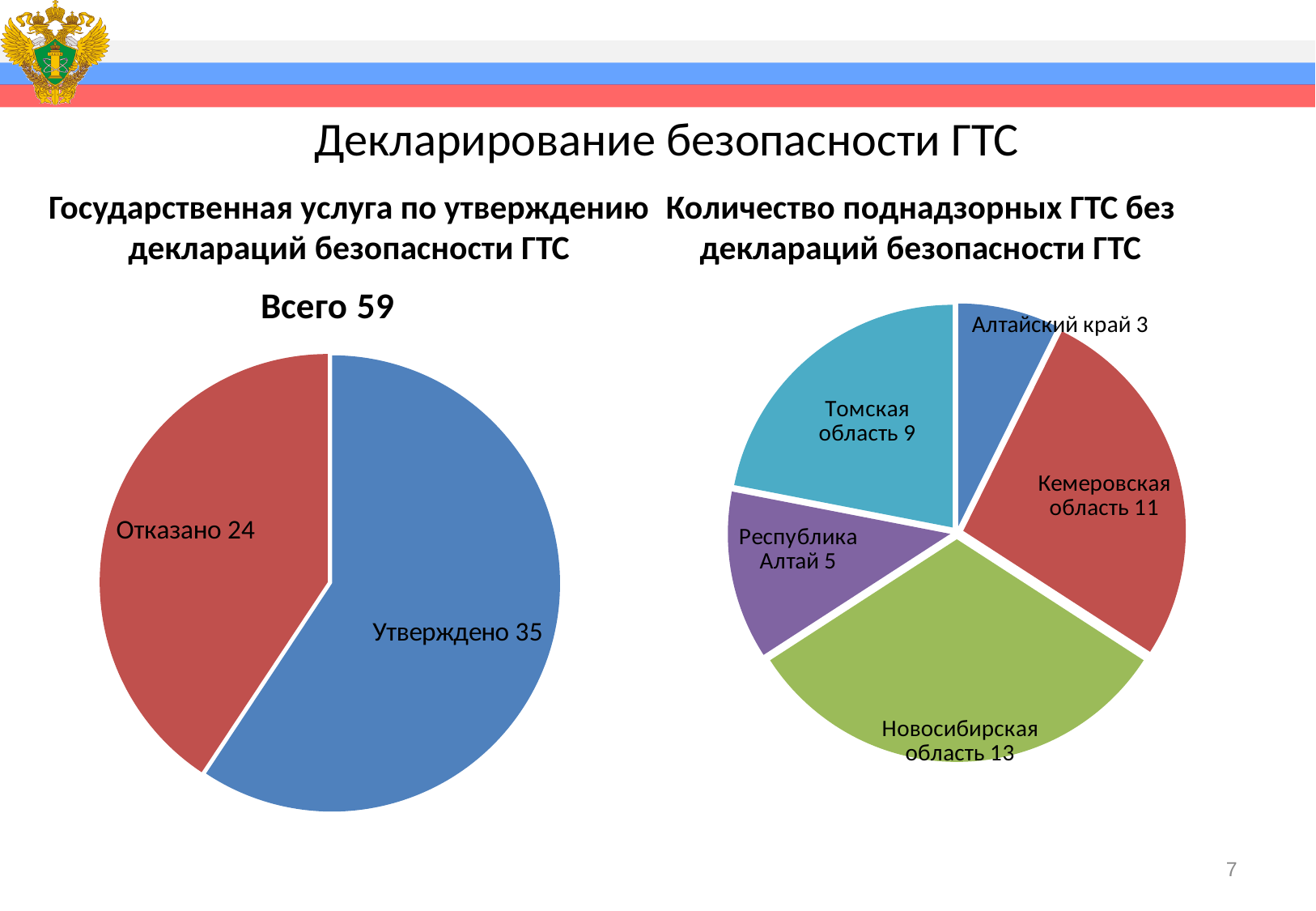
In the right pie chart, what is the value for Кемеровская область? 11 In the left pie chart, how many declarations were refused (Отказано)? 24 In the left pie chart, how many declarations were approved (Утверждено)? 35 What type of chart is used on the left, titled 'Государственная услуга по утверждению деклараций безопасности ГТС'? Pie chart In the left pie chart, what is the total number shown above the chart (Всего)? 59 In the right pie chart, what is the difference between Новосибирская область and Алтайский край? 10 In the right pie chart 'Количество поднадзорных ГТС без деклараций безопасности ГТС', how many slices are there? 5 In the right pie chart, which is larger: Республика Алтай or Томская область? Томская область In the right pie chart, what is the value for Томская область? 9 In the left pie chart, what is the difference between Утверждено and Отказано? 11 In the right pie chart, which region has the smallest number of ГТС without safety declarations? Алтайский край In the right pie chart, which region has the largest number of ГТС without safety declarations? Новосибирская область